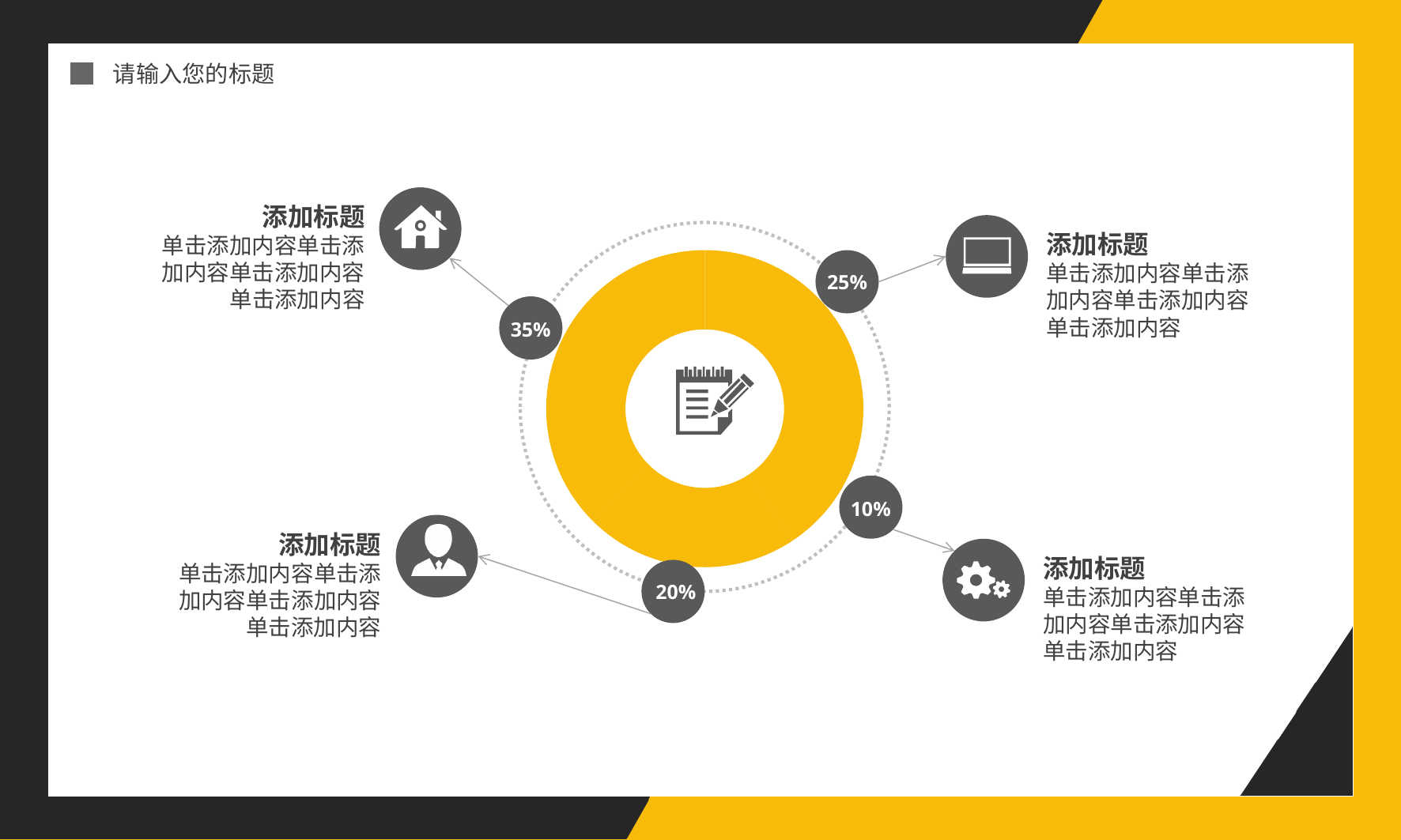
What is the difference between the largest and smallest percentages shown (35% and 10%)? 25% What is the percentage shown next to the person icon (lower left)? 20% What is the percentage shown next to the laptop icon (upper right)? 25% What kind of chart is shown in the centre of the slide? doughnut (pie) chart Which is the largest percentage shown on the chart? 35% What is the percentage shown next to the gear icon (lower right)? 10% What colour is the doughnut ring of the chart? yellow What is the percentage shown next to the house icon (upper left)? 35% Which is larger, the percentage next to the laptop icon or the percentage next to the person icon? laptop icon (25%) How many percentage labels are shown around the doughnut chart? 4 What is the sum of the four percentages shown on the chart? 90% Which is the smallest percentage shown on the chart? 10%